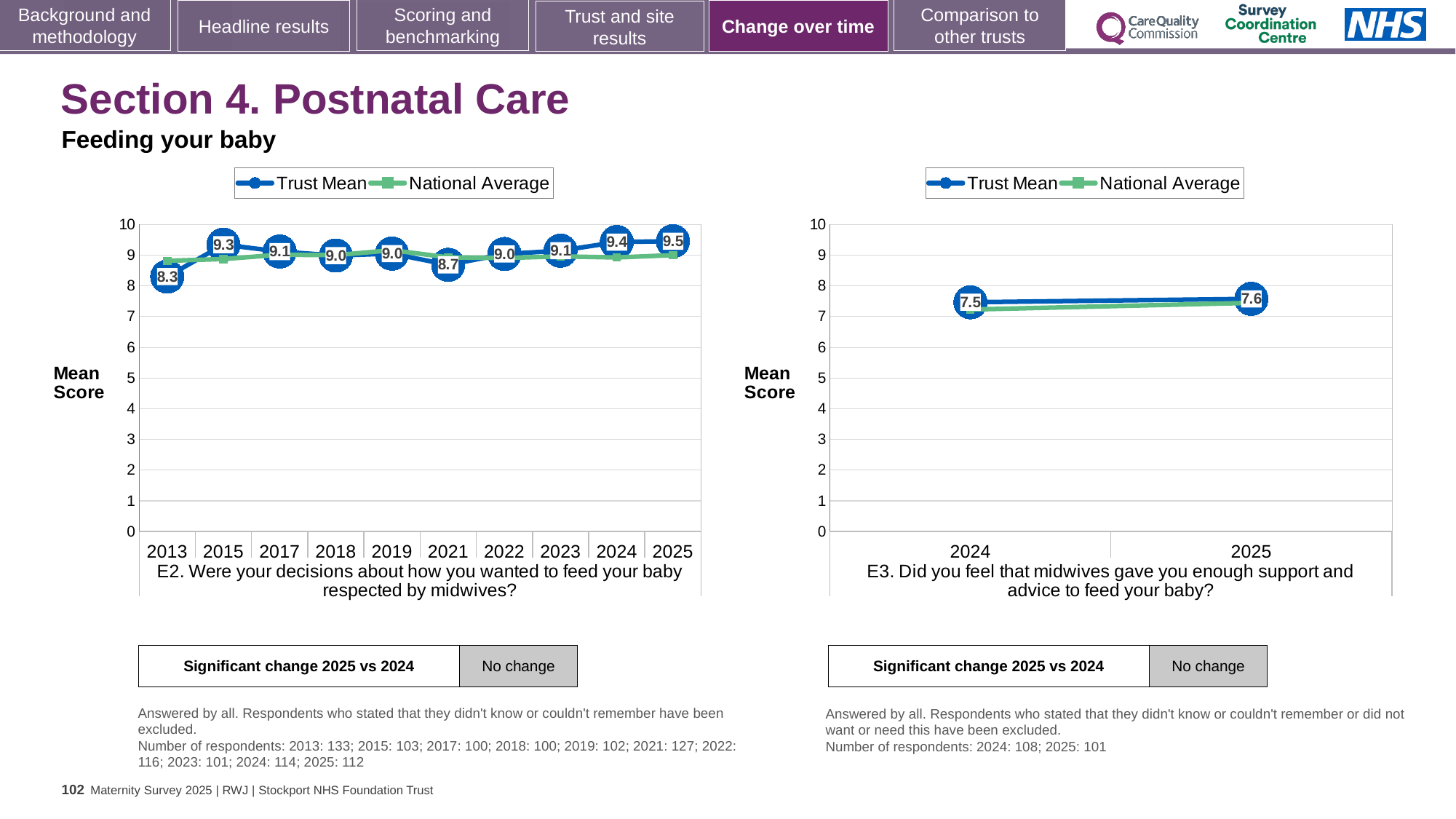
In the E3 chart (right), is the Trust Mean for 2025 higher or lower than for 2024? higher In the E2 chart (left), which year has the lowest Trust Mean? 2013 In the E3 chart (right), is the National Average for 2024 greater or less than 8? less In the E2 chart (left), what is the Trust Mean for 2013? 8.3 In the E3 chart (right), what is the Trust Mean for 2024? 7.5 In the E2 chart (left), what is the difference between the Trust Mean for 2025 and for 2013? 1.2 In the E2 chart (left), what is the Trust Mean for 2021? 8.7 In the E2 chart (left), what is the Trust Mean for 2025? 9.5 In the E2 chart (left), which year has the highest Trust Mean? 2025 In the E2 chart (left), how many years are shown on the x axis? 10 What kind of chart is the E2 chart (left)? line chart How many series does the legend of the E3 chart (right) list? 2